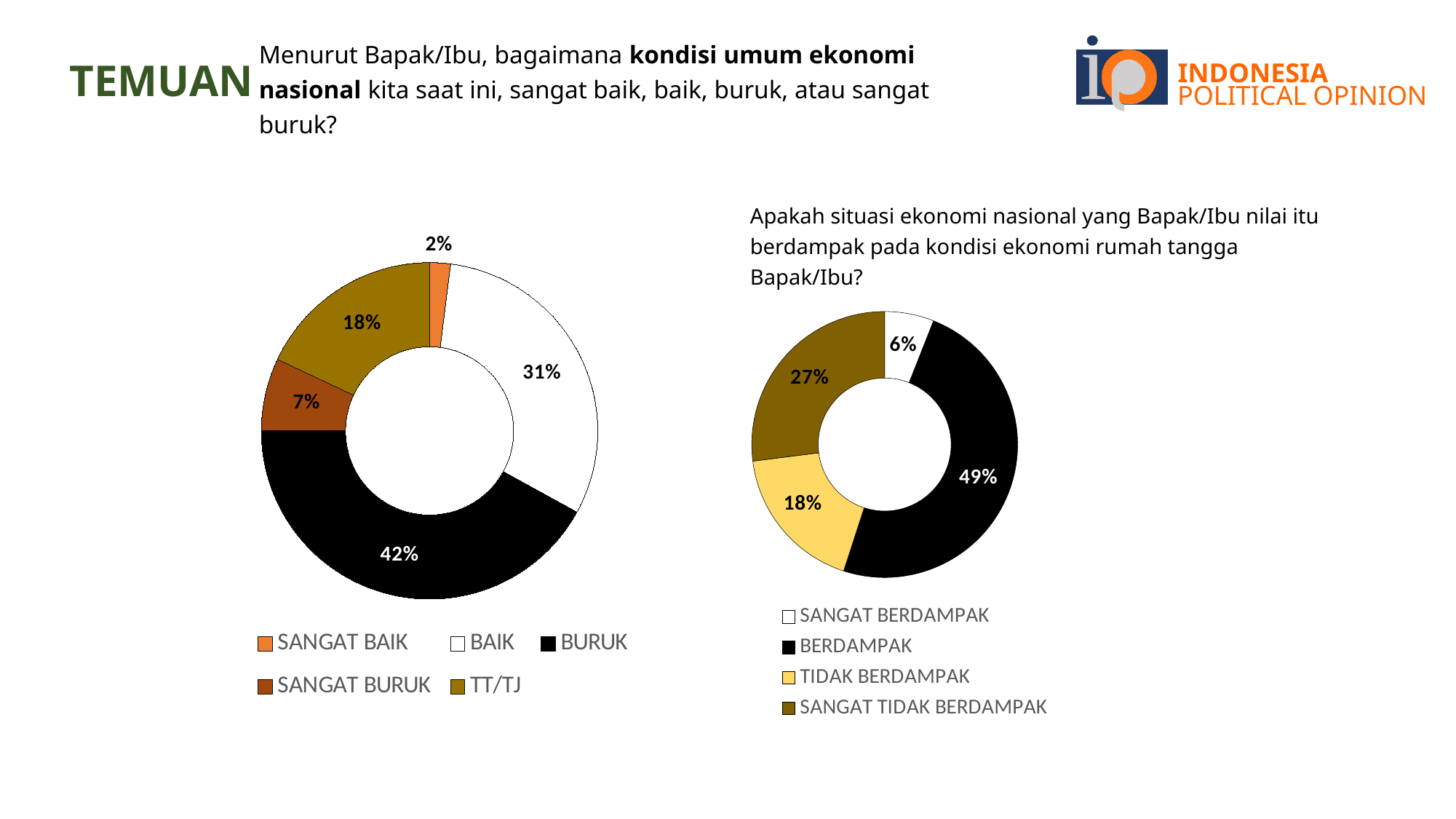
In the left chart, what percentage of respondents answered BURUK? 42% In the left chart, which category has the largest share? BURUK In the right chart, what colour represents BERDAMPAK? Black In the left chart, which category has the smallest share? SANGAT BAIK In the right chart, which is larger: TIDAK BERDAMPAK or SANGAT TIDAK BERDAMPAK? SANGAT TIDAK BERDAMPAK In the right chart, which category has the smallest share? SANGAT BERDAMPAK What type of chart is used on the right side of the slide? Doughnut chart In the left chart, how many categories does the legend list? 5 In the right chart, what percentage of respondents answered SANGAT TIDAK BERDAMPAK? 27% In the right chart, what percentage of respondents answered BERDAMPAK? 49% In the left chart, what is the difference in percentage points between BURUK and BAIK? 11 In the left chart, what percentage of respondents answered SANGAT BAIK? 2%